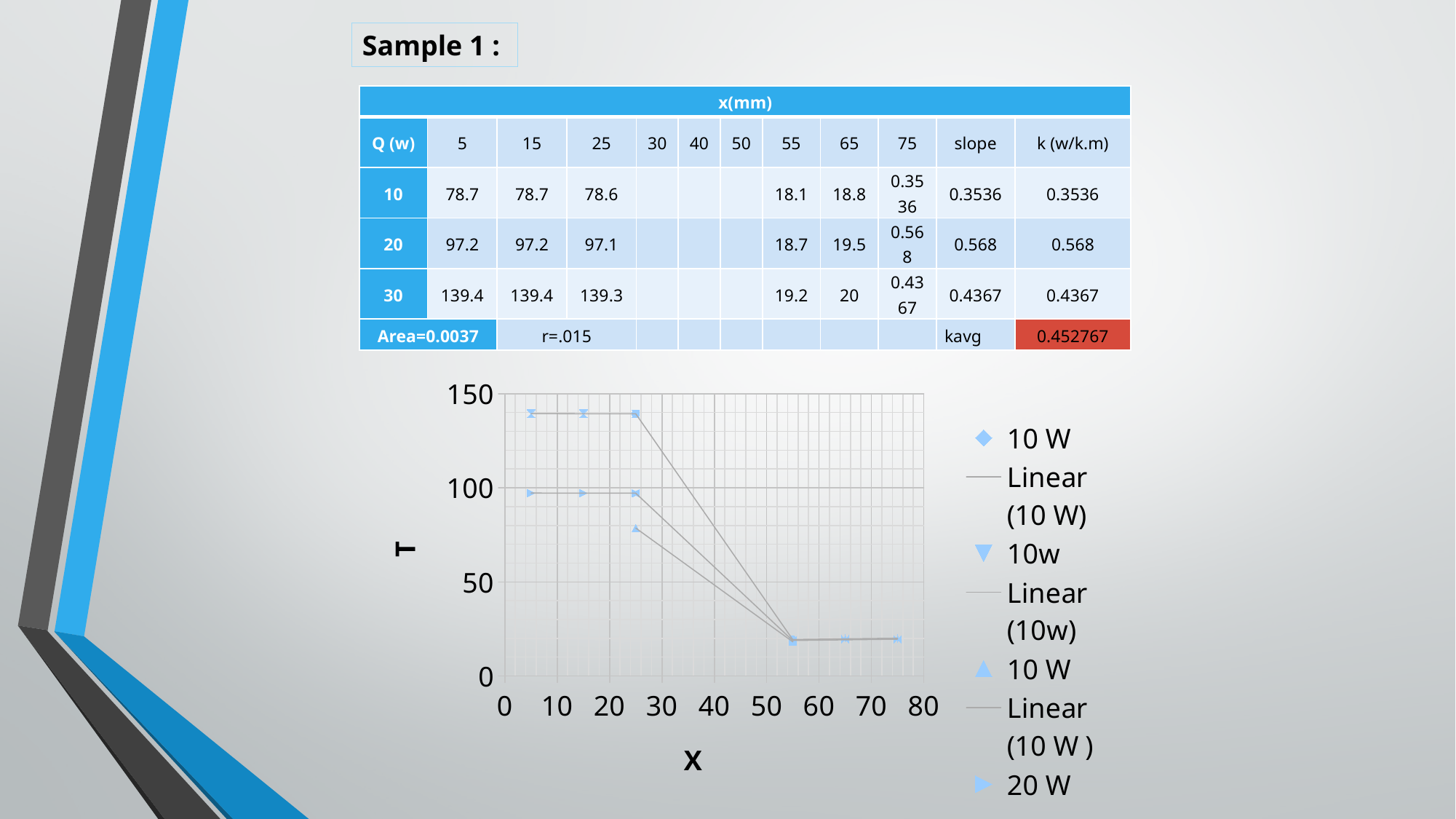
What kind of chart is shown on the slide? scatter chart How many distinct x positions have plotted points in the chart? 6 What is the highest tick value shown on the y axis of the chart? 150 Do the plotted values rise or fall as x increases from 25 to 55? fall What is the label on the x axis of the chart? X Is the lowest plotted value at x = 25 greater or less than 50? greater What is the label on the y axis of the chart? T Are the plotted values at x = 55 greater or less than 50? less Is the highest plotted value at x = 5 greater or less than 100? greater For the topmost series, is the value at x = 5 larger or smaller than the value at x = 65? larger